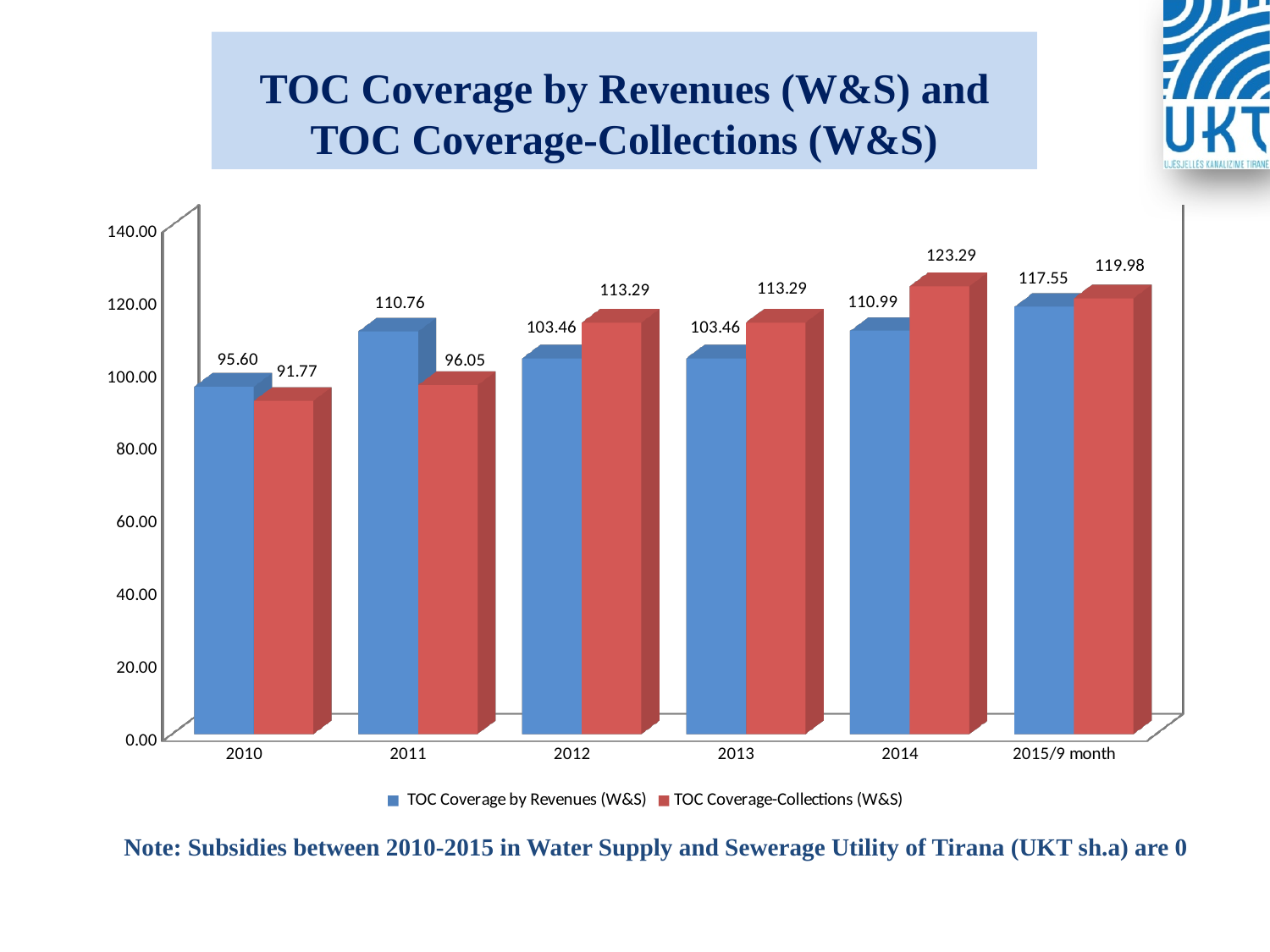
Which year has the highest TOC Coverage-Collections (W&S) value? 2014 What is the TOC Coverage-Collections (W&S) value for 2014? 123.29 Is the TOC Coverage-Collections (W&S) value for 2010 greater or less than 100.00? less What is the difference between TOC Coverage-Collections (W&S) and TOC Coverage by Revenues (W&S) in 2014? 12.30 How many categories are shown on the x axis? 6 In 2011, which is larger: TOC Coverage by Revenues (W&S) or TOC Coverage-Collections (W&S)? TOC Coverage by Revenues (W&S) Which category has the lowest TOC Coverage by Revenues (W&S) value? 2010 How many series does the legend list? 2 What is the TOC Coverage-Collections (W&S) value for 2011? 96.05 What colour are the TOC Coverage-Collections (W&S) bars? red What kind of chart is shown on the slide? bar chart What is the TOC Coverage by Revenues (W&S) value for 2010? 95.60